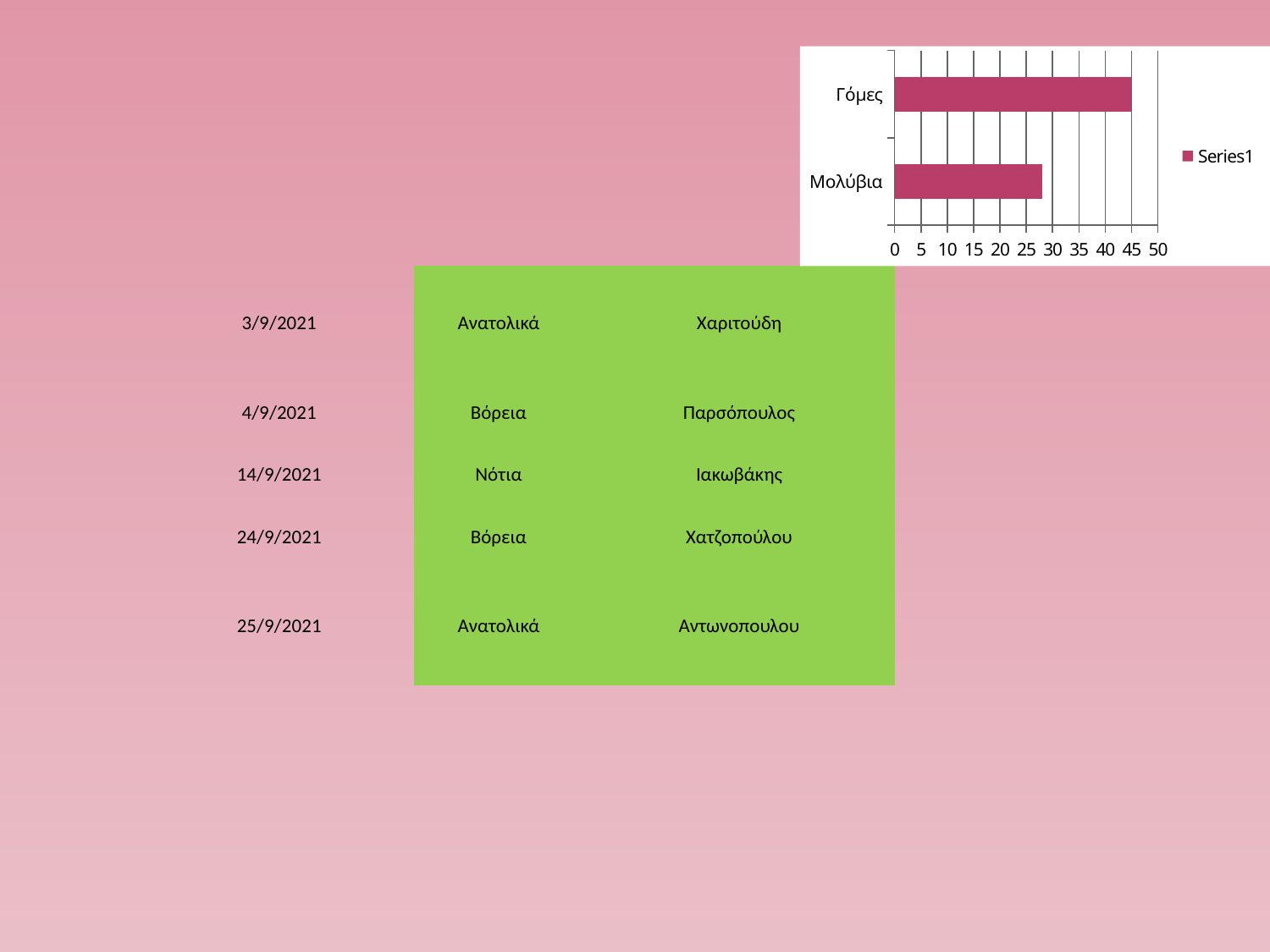
What is the name of the series shown in the chart legend? Series1 What is the value for Γόμες in the chart? 45 Which category has the highest value in the chart? Γόμες Which category has the lowest value in the chart? Μολύβια What is the highest value shown on the chart's horizontal axis? 50 Is the value for Γόμες greater or less than 40? greater What kind of chart is shown on the slide? bar chart Is the value for Μολύβια greater or less than 25? greater Which is larger, the value for Γόμες or the value for Μολύβια? Γόμες Is the value for Μολύβια greater or less than 30? less How many categories are plotted in the chart? 2 How many series does the chart legend list? 1